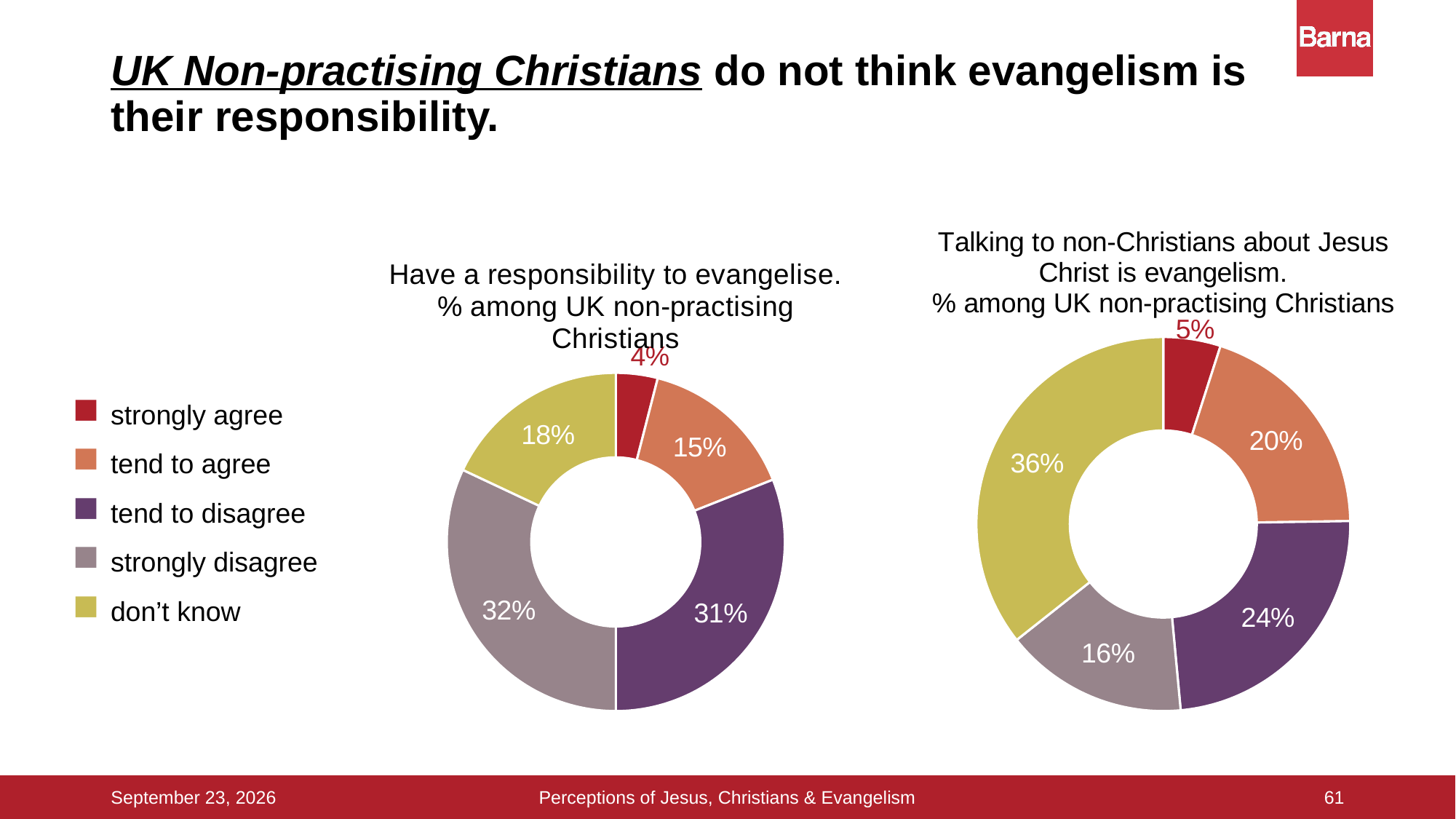
In the 'Talking to non-Christians about Jesus Christ is evangelism' chart, which category has the largest share? don't know In the 'Talking to non-Christians about Jesus Christ is evangelism' chart, what is the difference between 'don't know' and 'strongly agree'? 31% In the 'Have a responsibility to evangelise' chart, what is the difference between 'strongly disagree' and 'tend to disagree'? 1% In the 'Talking to non-Christians about Jesus Christ is evangelism' chart, what percentage is shown for 'don't know'? 36% In the 'Have a responsibility to evangelise' chart, which category has the smallest share? strongly agree In the 'Have a responsibility to evangelise' chart, what percentage is shown for 'strongly disagree'? 32% Which is larger in the 'Have a responsibility to evangelise' chart: 'don't know' or 'tend to agree'? don't know How many categories does the legend list? 5 What kind of chart is used on this slide? Doughnut (pie) chart In the 'Have a responsibility to evangelise' chart, what percentage is shown for 'tend to agree'? 15% In the 'Talking to non-Christians about Jesus Christ is evangelism' chart, what percentage is shown for 'tend to disagree'? 24% What colour represents 'strongly agree' in the legend? Red